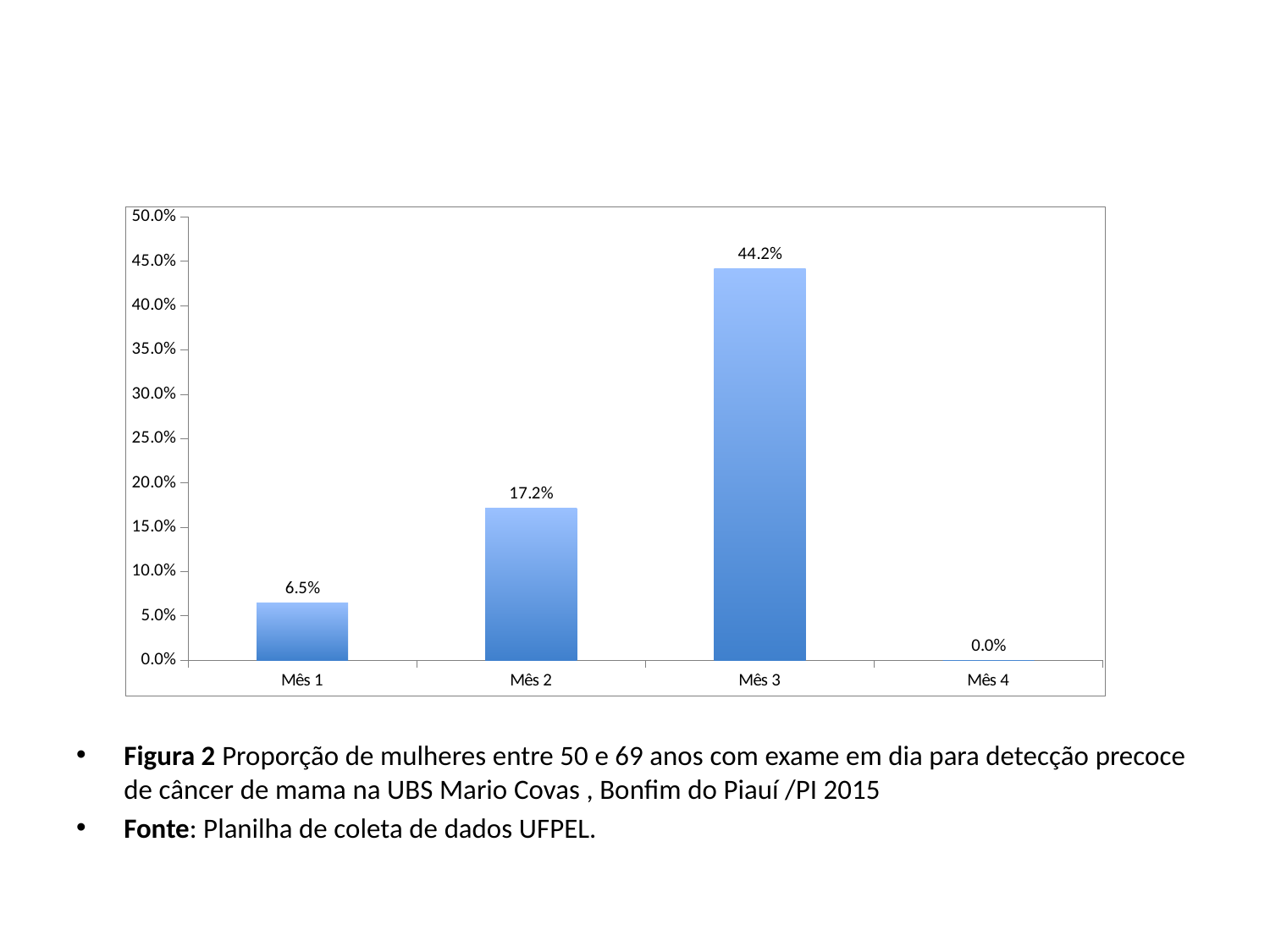
What is the value for Mês 2? 17.2% What is the value for Mês 3? 44.2% Which month has the highest value? Mês 3 What is the difference between the values for Mês 2 and Mês 1? 10.7% Which is larger, the value for Mês 1 or the value for Mês 2? Mês 2 What is the value for Mês 4? 0.0% What kind of chart is shown on the slide? bar chart Is the value for Mês 3 greater or less than 40.0%? greater Which month has the lowest value? Mês 4 What is the value for Mês 1? 6.5% How many months are shown on the x axis? 4 What is the difference between the values for Mês 3 and Mês 2? 27.0%